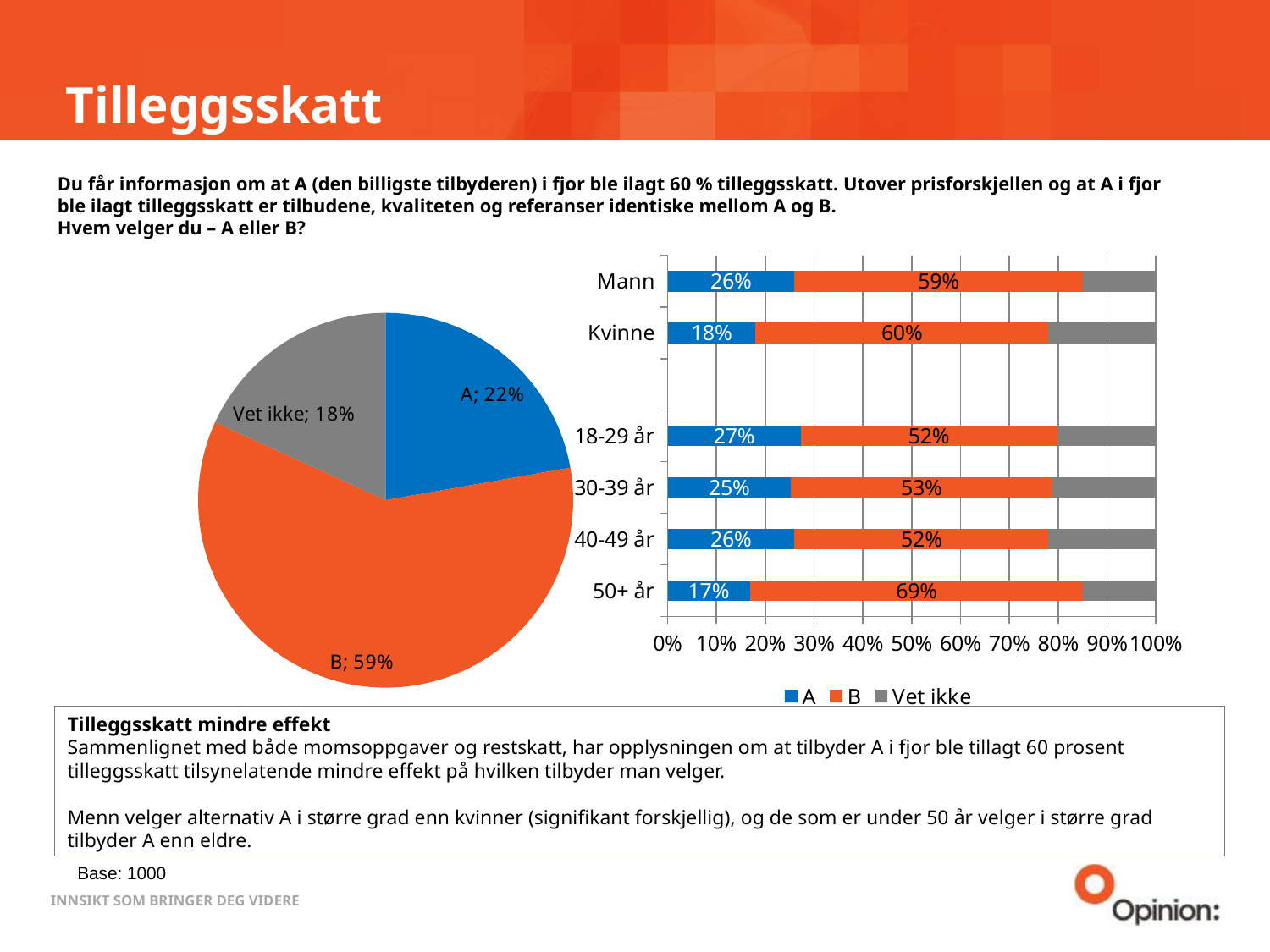
In the bar chart on the right, what is the difference between the A values for 'Mann' and 'Kvinne'? 8 percentage points In the bar chart on the right, which category has the highest value for B? 50+ år In the bar chart on the right, what is the value for B among 'Kvinne'? 60% In the pie chart on the left, what share of respondents chose A? 22% In the bar chart on the right, which category has the lowest value for A? 50+ år In the bar chart on the right, what is the value for A among '50+ år'? 17% In the bar chart on the right, how many series does the legend list? 3 What kind of chart is shown on the right side of the slide? Stacked bar chart In the pie chart on the left, which slice is the largest? B In the pie chart on the left, what share of respondents answered 'Vet ikke'? 18% In the bar chart on the right, which is larger: the B value for '18-29 år' or the B value for '30-39 år'? 30-39 år In the pie chart on the left, how many slices are there? 3